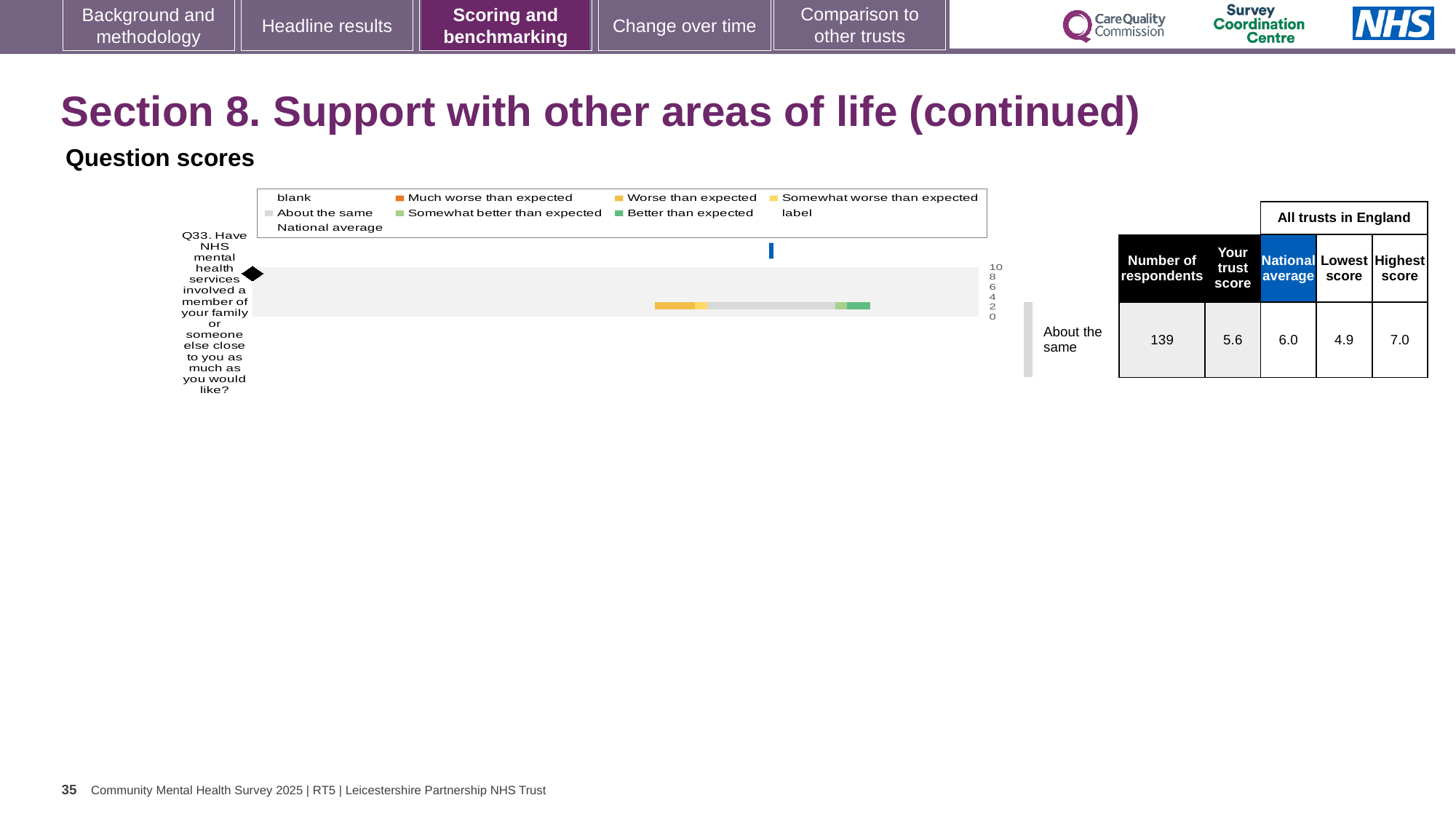
What kind of chart is shown under 'Question scores'? bar chart What benchmark category is the trust's Q33 score placed in? About the same What is the difference between the national average and the trust's score for Q33? 0.4 What is the difference between the highest and lowest scores among all trusts in England for Q33? 2.1 How many respondents answered Q33? 139 What is the national average score for Q33? 6.0 What is the lowest score among all trusts in England for Q33? 4.9 What is the trust's score for Q33? 5.6 Which question is plotted in the Question scores chart? Q33. Have NHS mental health services involved a member of your family or someone else close to you as much as you would like? Is the trust's score for Q33 higher or lower than the national average? lower What is the highest score among all trusts in England for Q33? 7.0 How many questions are plotted in the Question scores chart? 1